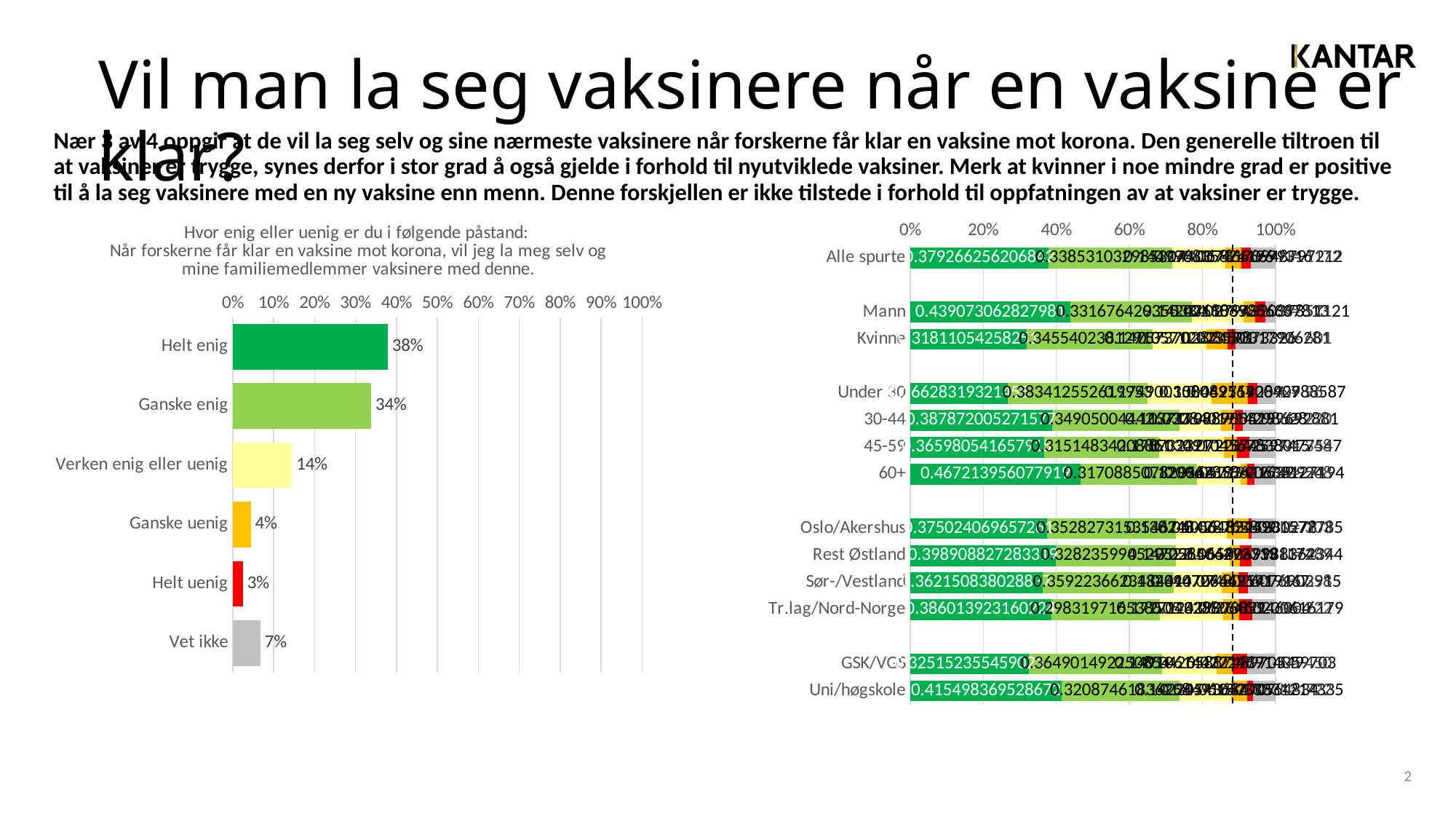
In the left chart, which is larger: "Verken enig eller uenig" or "Vet ikke"? Verken enig eller uenig In the right chart, is the dark green (first) segment for "60+" greater or less than 40%? greater What kind of chart is the left chart? Bar chart In the left chart, how many categories are shown? 6 In the right chart, which has the larger dark green (first) segment: "Mann" or "Kvinne"? Mann In the left chart, which category has the lowest value? Helt uenig In the left chart, what percentage of respondents answered "Helt enig"? 38% In the left chart, what is the value for "Ganske enig"? 34% In the left chart, what is the difference between "Helt enig" and "Ganske enig"? 4 percentage points In the right chart, how many groups (categories) are listed on the vertical axis? 13 In the left chart, which category has the highest value? Helt enig In the left chart, what is the value for "Vet ikke"? 7%